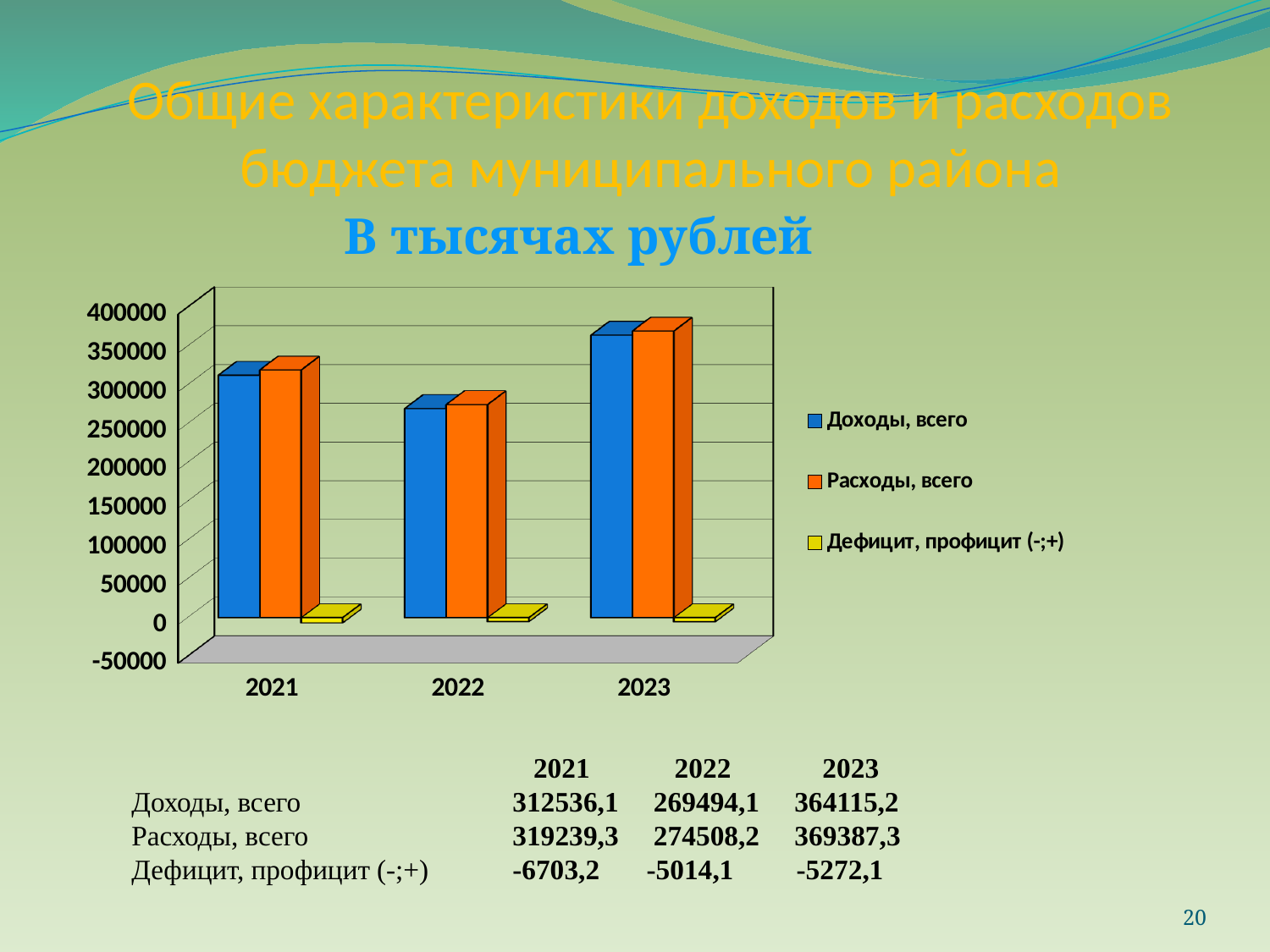
How many series does the chart legend list? 3 In which year is "Доходы, всего" the highest? 2023 In which year is "Расходы, всего" the lowest? 2022 What colour are the bars for "Дефицит, профицит (-;+)" in the chart? yellow What is the value of "Расходы, всего" for 2021? 319239,3 What is the value of "Доходы, всего" for 2023? 364115,2 Is the value of "Доходы, всего" for 2022 greater or less than 300000? less What is the difference between "Расходы, всего" and "Доходы, всего" in 2023? 5272,1 What is the value of "Дефицит, профицит (-;+)" for 2022? -5014,1 What kind of chart is shown on the slide? bar chart Which is larger in 2022: "Доходы, всего" or "Расходы, всего"? Расходы, всего How many years are shown on the x axis of the chart? 3